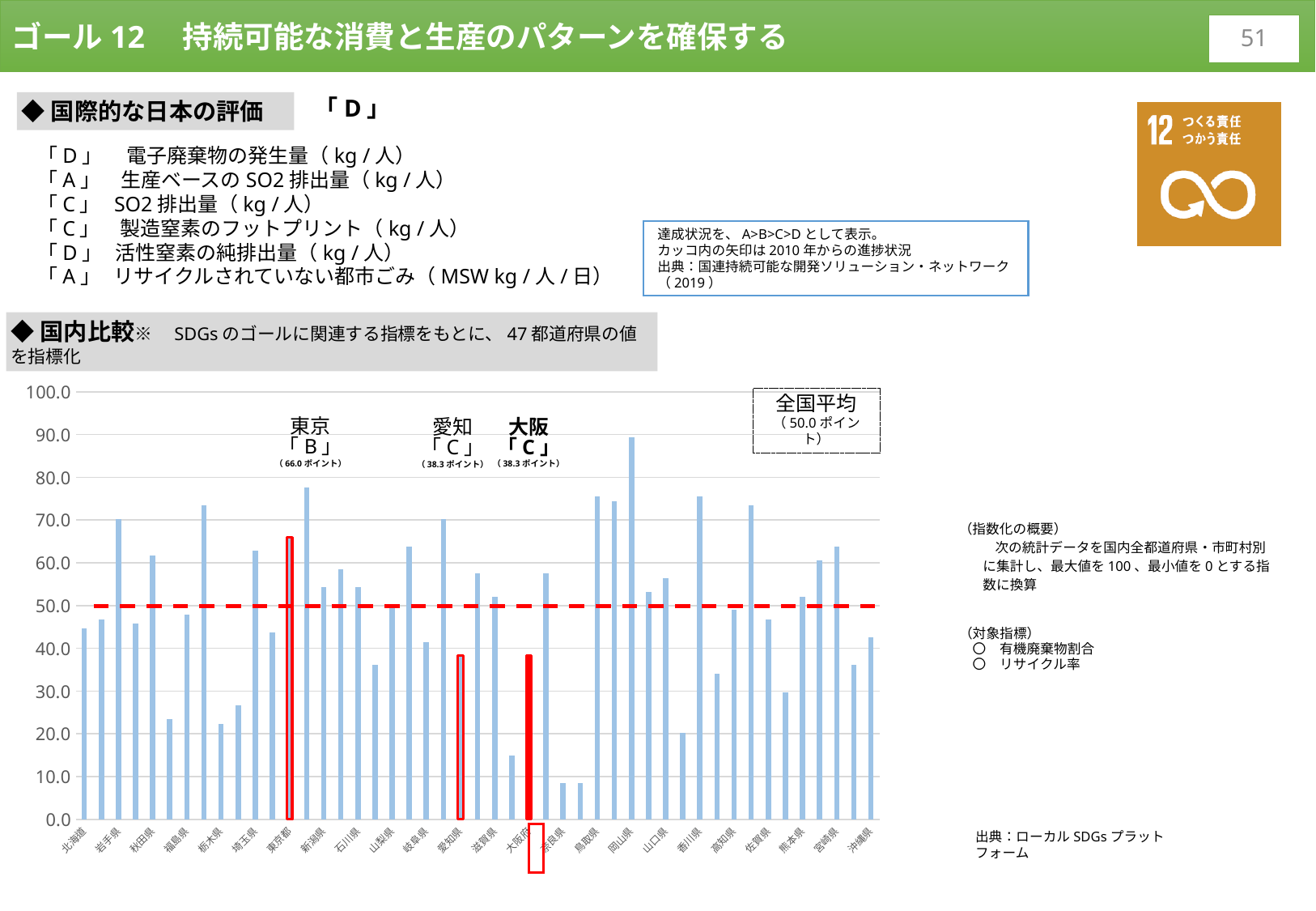
In the 国内比較 bar chart, what does the red dashed horizontal line represent? 全国平均（50.0 ポイント） What kind of chart is used for the 国内比較 section? bar chart In the 国内比較 bar chart, what is the difference between the value for 東京 and the value for 愛知? 27.7 ポイント In the 国内比較 bar chart, is the value for 鳥取県 greater or less than 70.0? greater In the 国内比較 bar chart, what is the value for 愛知? 38.3 ポイント In the 国内比較 bar chart, which is larger, the value for 東京 or the value for 愛知? 東京 In the 国内比較 bar chart, is the value for 奈良県 greater or less than 10.0? less In the 国内比較 bar chart, is the value for 岡山県 greater or less than 80.0? greater In the 国内比較 bar chart, what is the value for 大阪? 38.3 ポイント In the 国内比較 bar chart, what is the value for 東京? 66.0 ポイント In the 国内比較 bar chart, what is the 全国平均 value? 50.0 ポイント